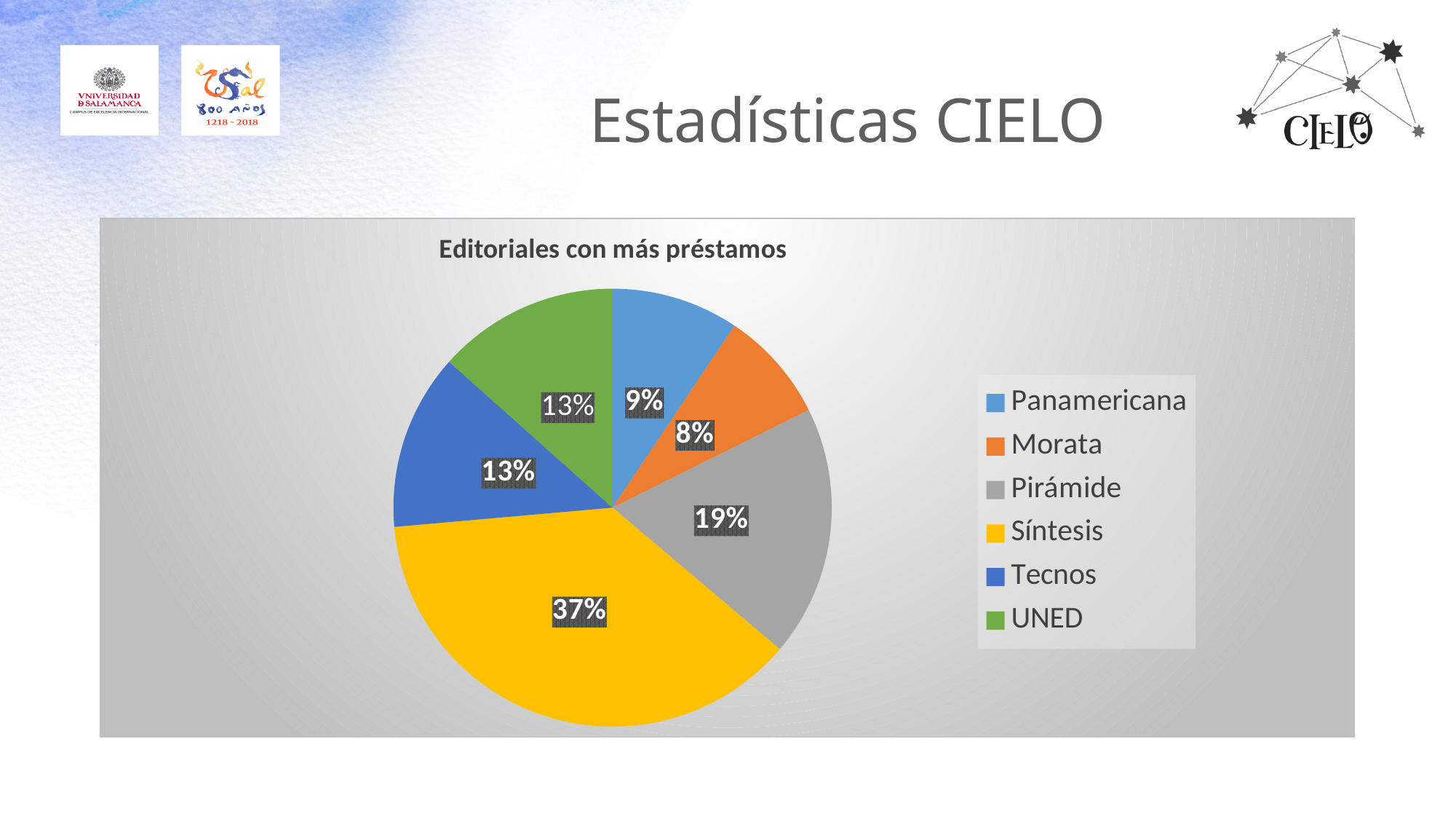
What share of the pie does Síntesis have? 37% What is the value shown for Morata? 8% Which publisher has the largest share of the pie? Síntesis What type of chart is shown on the slide? pie chart What is the value shown for Panamericana? 9% What is the title of the chart? Editoriales con más préstamos Which publisher has the smallest share of the pie? Morata How many categories does the legend list? 6 What share of the pie does Pirámide have? 19% What colour is the slice for UNED? green Which is larger, the share for Pirámide or the share for Tecnos? Pirámide What is the difference between the shares of Síntesis and Pirámide? 18%